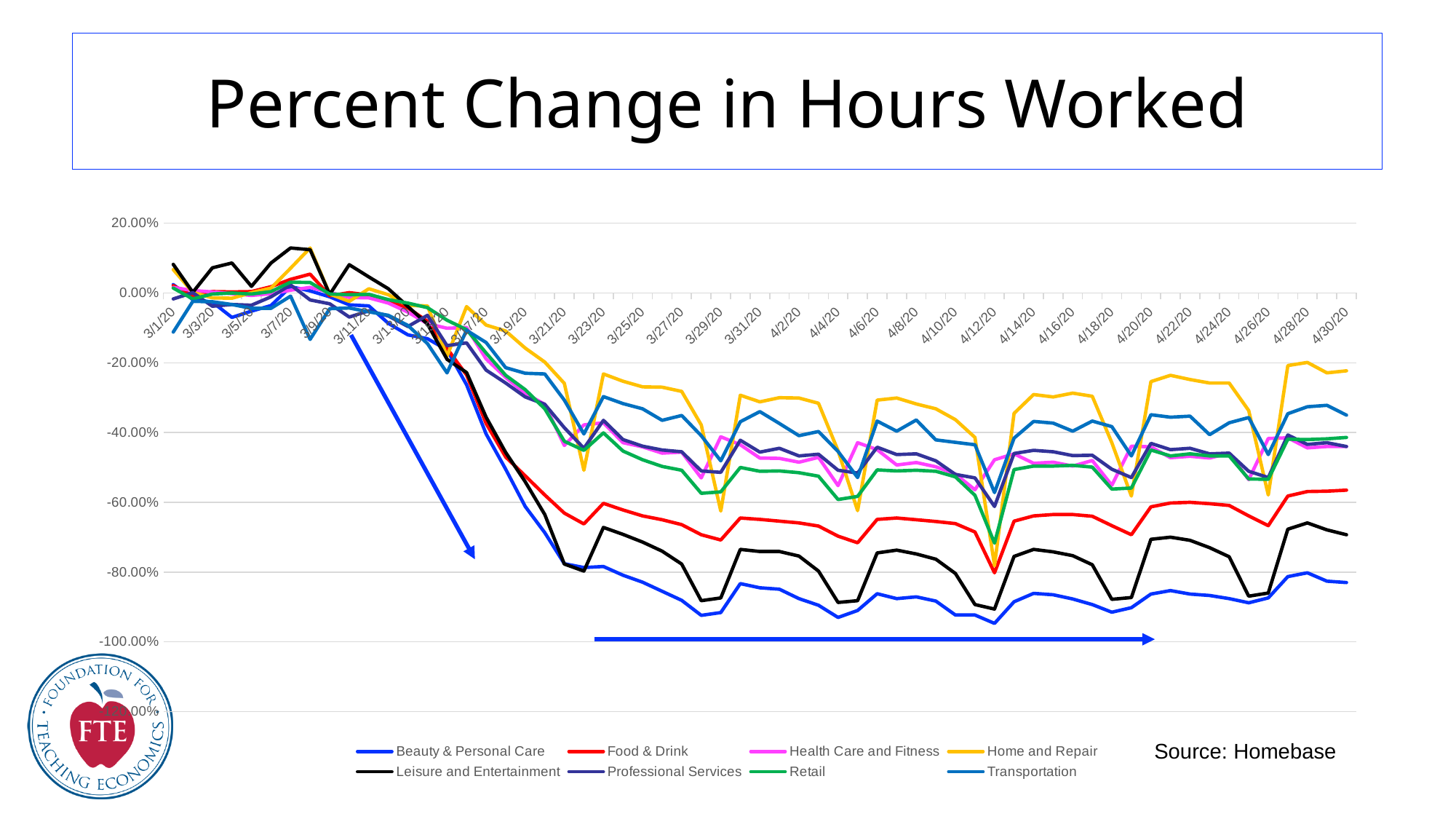
Is the value for Home and Repair on 4/30/20 greater or less than -40.00%? greater What kind of chart is shown on the slide? Line chart On 4/30/20, which is higher: Food & Drink or Leisure and Entertainment? Food & Drink Does the Beauty & Personal Care line rise or fall between 3/11/20 and 3/23/20? Fall Which series has the highest value on 4/30/20? Home and Repair Which series has the lowest value on 4/30/20? Beauty & Personal Care Is the value for Beauty & Personal Care on 4/30/20 greater or less than -60.00%? less What is the title of the chart? Percent Change in Hours Worked Is the value for Food & Drink on 4/30/20 greater or less than -40.00%? less How many series does the legend list? 8 Overall, do the series values rise or fall from 3/1/20 to 4/30/20? Fall What source is cited for the chart data? Homebase